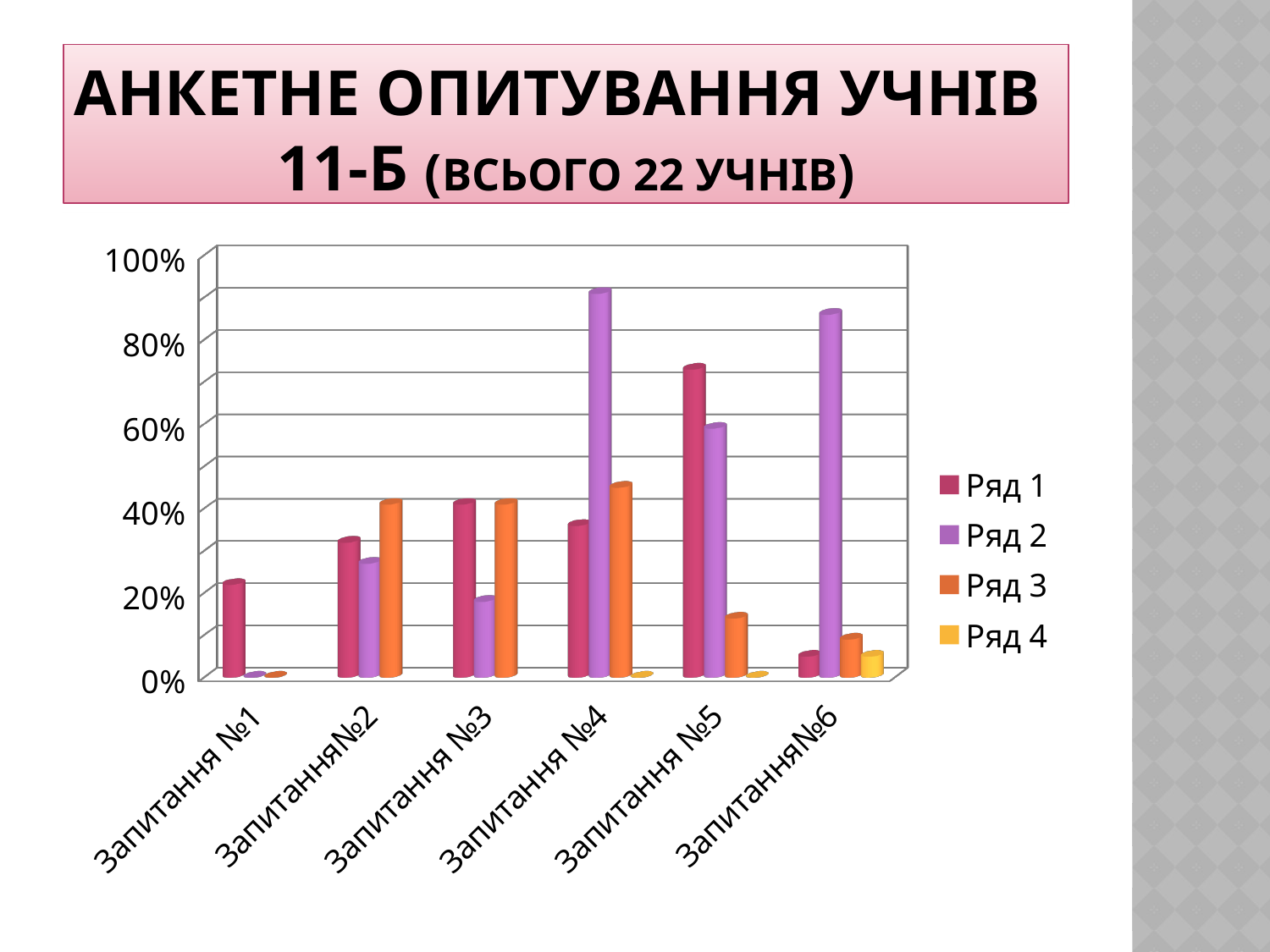
What is the title of the slide containing the chart? АНКЕТНЕ ОПИТУВАННЯ УЧНІВ 11-Б (ВСЬОГО 22 УЧНІВ) How many categories (questions) are shown on the x axis? 6 What kind of chart is shown on the slide? bar chart Is the value of Ряд 3 for Запитання №5 greater or less than 20%? less Is the value of Ряд 2 for Запитання №6 greater or less than 80%? greater Is the value of Ряд 1 for Запитання №5 greater or less than 60%? greater For which category does Ряд 1 reach its highest value? Запитання №5 For Запитання №5, which is larger: Ряд 1 or Ряд 2? Ряд 1 For which category does Ряд 2 reach its highest value? Запитання №4 How many series does the legend list? 4